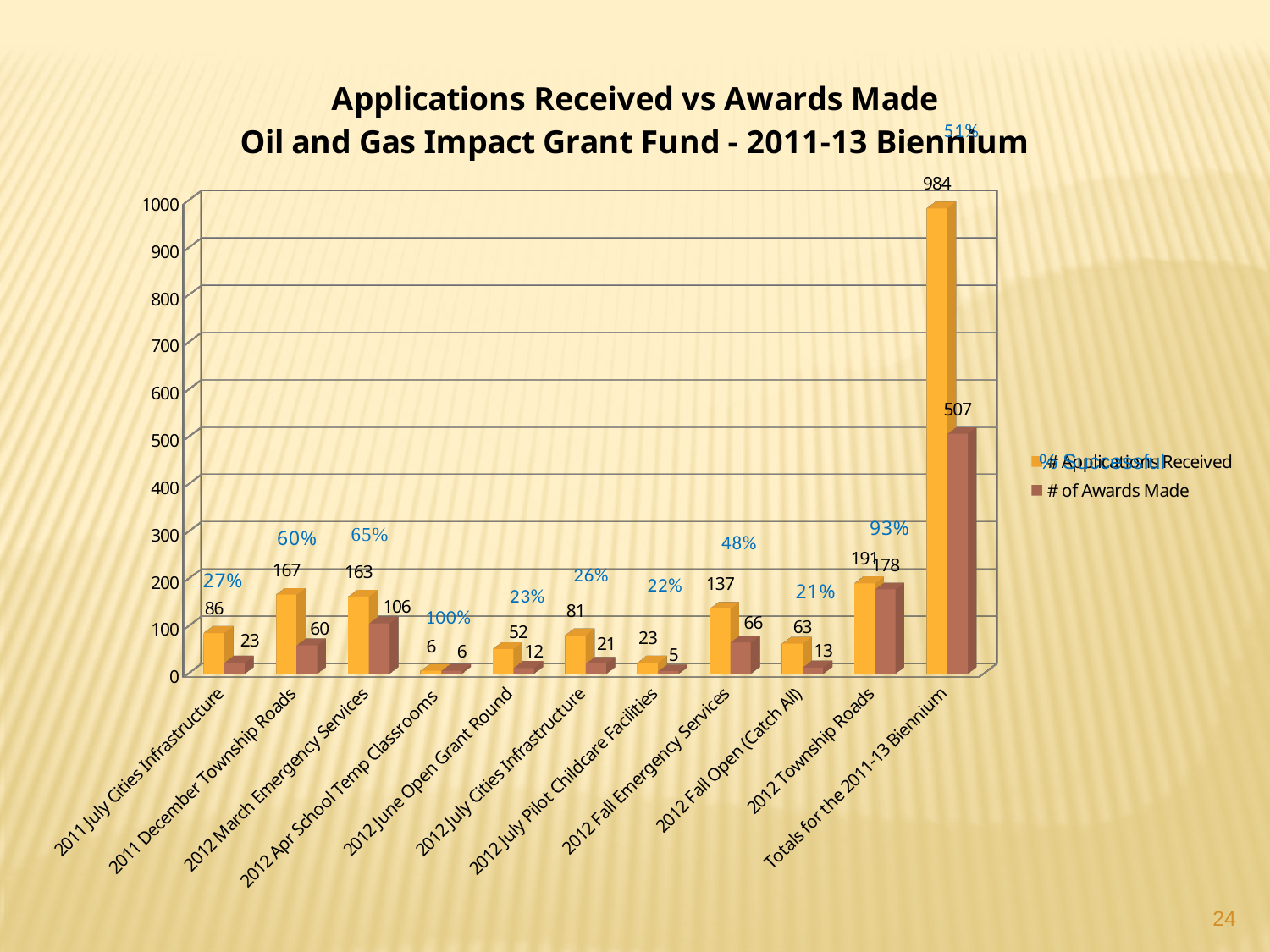
What is the number of applications received in the Totals for the 2011-13 Biennium? 984 What is the difference between applications received and awards made for 2011 December Township Roads? 107 How many awards were made for 2012 March Emergency Services? 106 What kind of chart is shown on the slide? bar chart What is the title of the chart? Applications Received vs Awards Made Oil and Gas Impact Grant Fund - 2011-13 Biennium Which is larger: the number of awards made for 2012 Fall Emergency Services or for 2011 December Township Roads? 2012 Fall Emergency Services Excluding the Totals category, which grant round has the highest number of applications received? 2012 Township Roads What percentage is shown above the 2012 Apr School Temp Classrooms bars? 100% Which category has the lowest number of awards made? 2012 July Pilot Childcare Facilities How many applications were received for 2012 Township Roads? 191 How many series does the legend list? 2 How many categories are shown on the x axis? 11